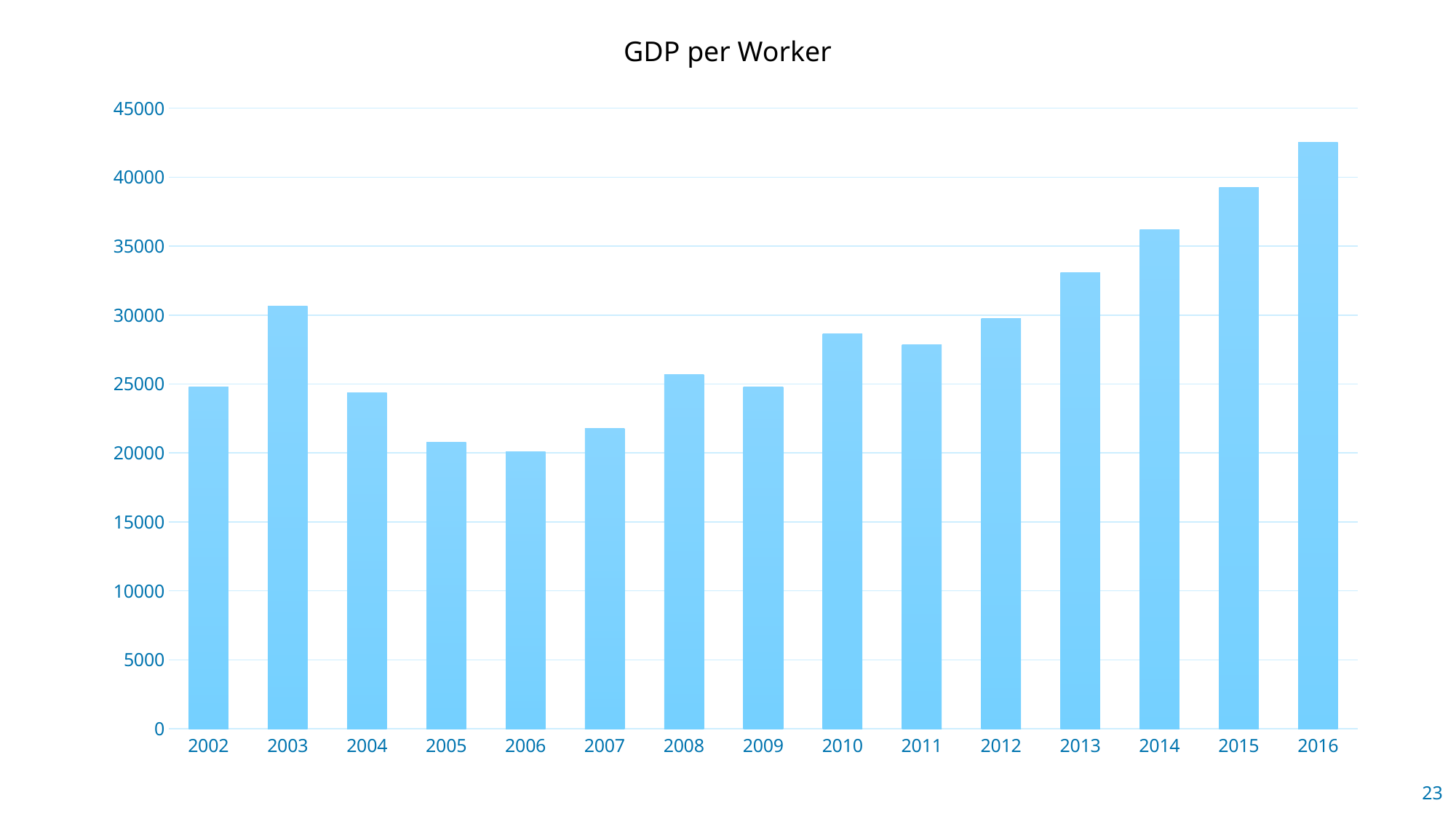
Which year has a higher GDP per worker, 2010 or 2011? 2010 How many years are shown on the x axis of the chart? 15 Which year has the highest GDP per worker? 2016 Is the value for 2016 greater or less than 40000? greater Do the values rise or fall from 2006 to 2016? rise Is the value for 2015 greater or less than 40000? less Is the value for 2003 greater or less than 30000? greater What kind of chart is shown on the slide? bar chart Which year has a higher GDP per worker, 2003 or 2004? 2003 What is the title of the chart? GDP per Worker Which year has the lowest GDP per worker? 2006